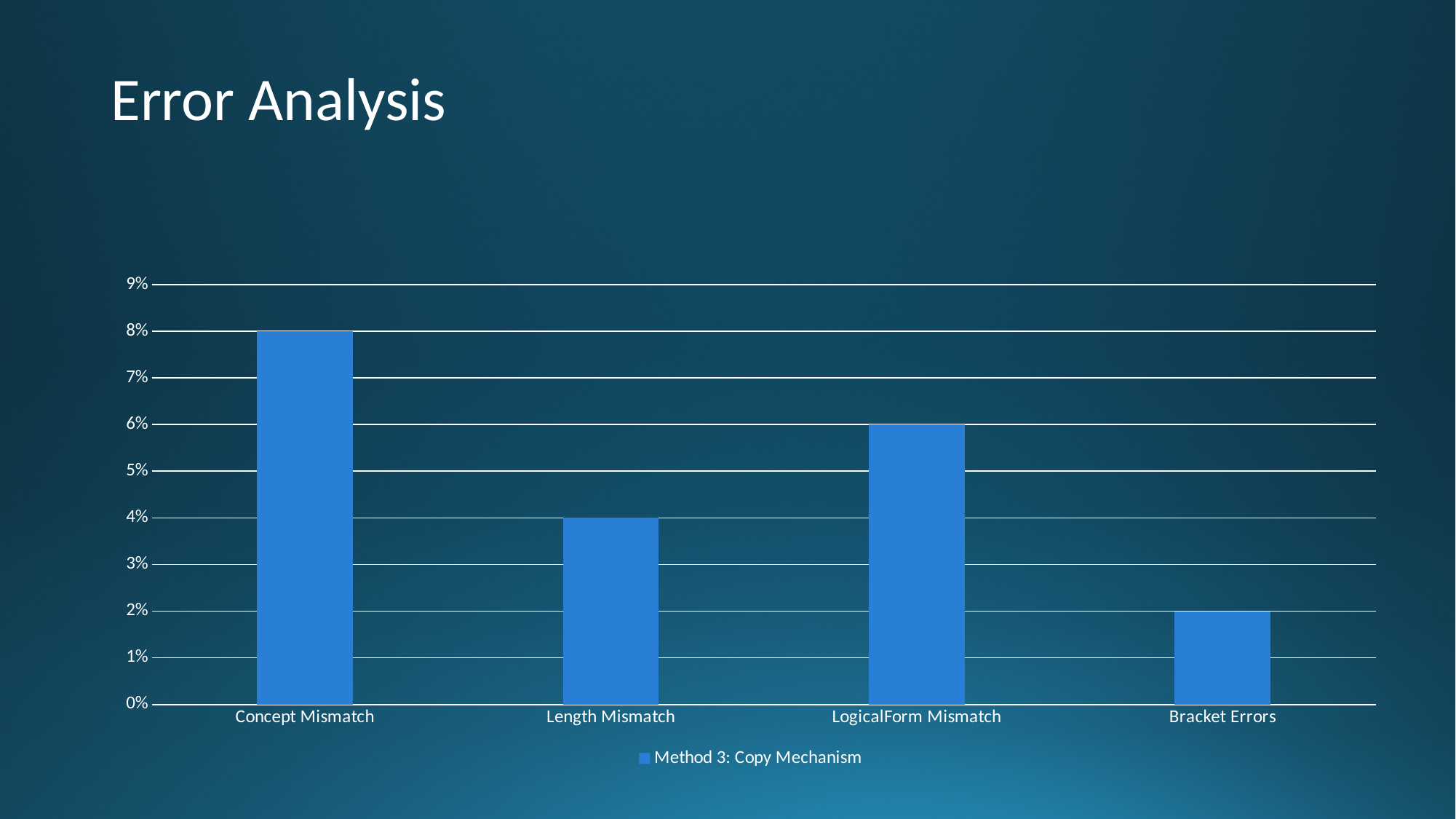
What kind of chart is shown on the slide? bar chart Which category has the lowest value? Bracket Errors What is the difference between the values for Concept Mismatch and Bracket Errors? 6% Is the value for LogicalForm Mismatch greater or less than 5%? greater What is the value for Bracket Errors? 2% How many series does the legend list? 1 What is the value for Concept Mismatch? 8% How many categories are shown on the x axis? 4 What is the value for LogicalForm Mismatch? 6% Which category has the highest value? Concept Mismatch What is the value for Length Mismatch? 4% Which is larger, the value for Length Mismatch or the value for LogicalForm Mismatch? LogicalForm Mismatch